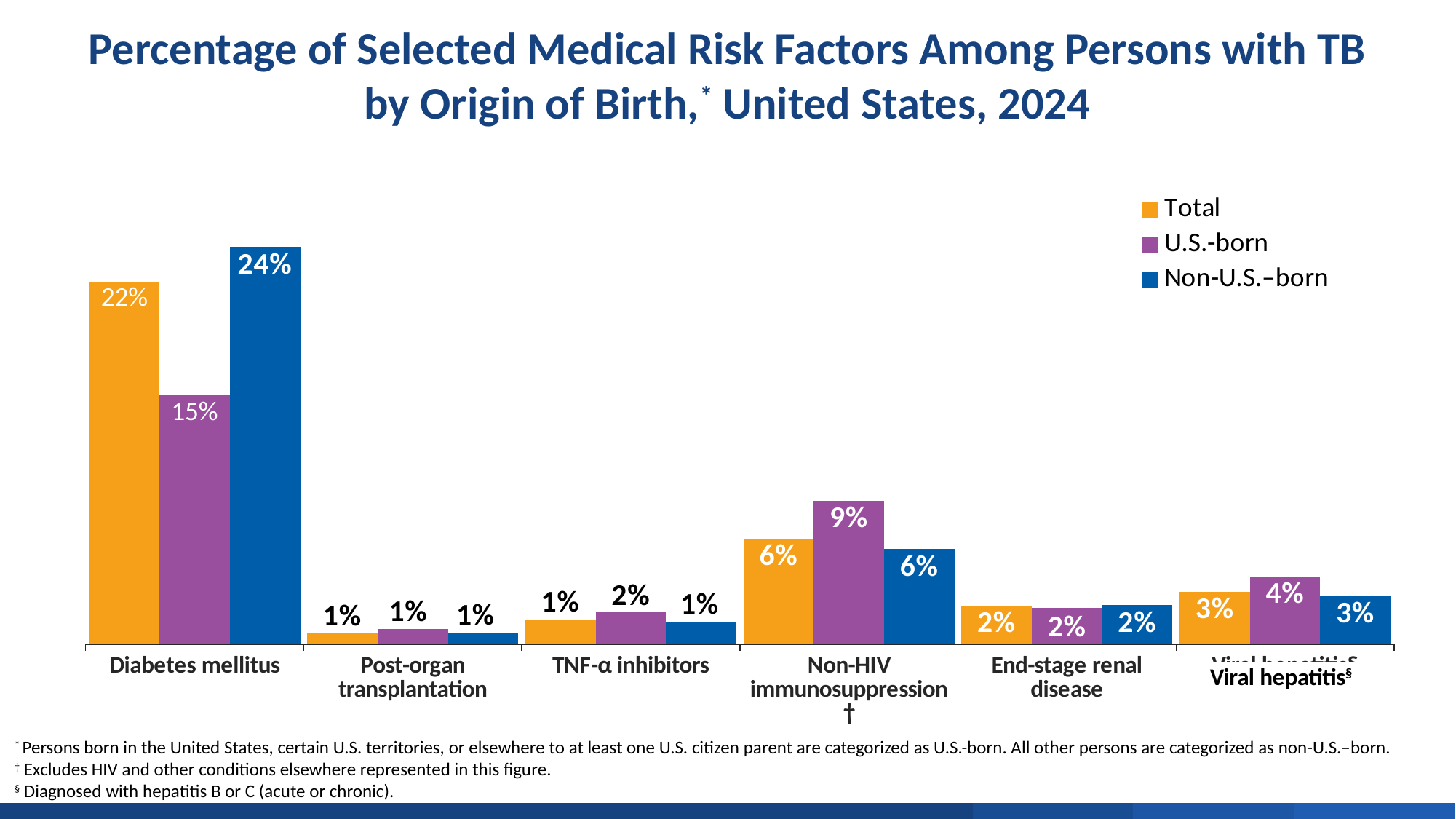
What is the difference between the Non-U.S.–born and U.S.-born values for Diabetes mellitus? 9% How many series does the legend list? 3 What is the Total value for Viral hepatitis? 3% What is the Non-U.S.–born value for Diabetes mellitus? 24% How many risk factor categories are shown on the x axis? 6 What is the difference between the U.S.-born and Total values for Non-HIV immunosuppression? 3% What is the U.S.-born value for Non-HIV immunosuppression? 9% For Non-HIV immunosuppression, which is larger: the U.S.-born value or the Non-U.S.–born value? U.S.-born What kind of chart is shown on the slide? Bar chart For Diabetes mellitus, which is larger: the Total value or the U.S.-born value? Total What is the U.S.-born value for TNF-α inhibitors? 2% Which risk factor has the highest Total value? Diabetes mellitus